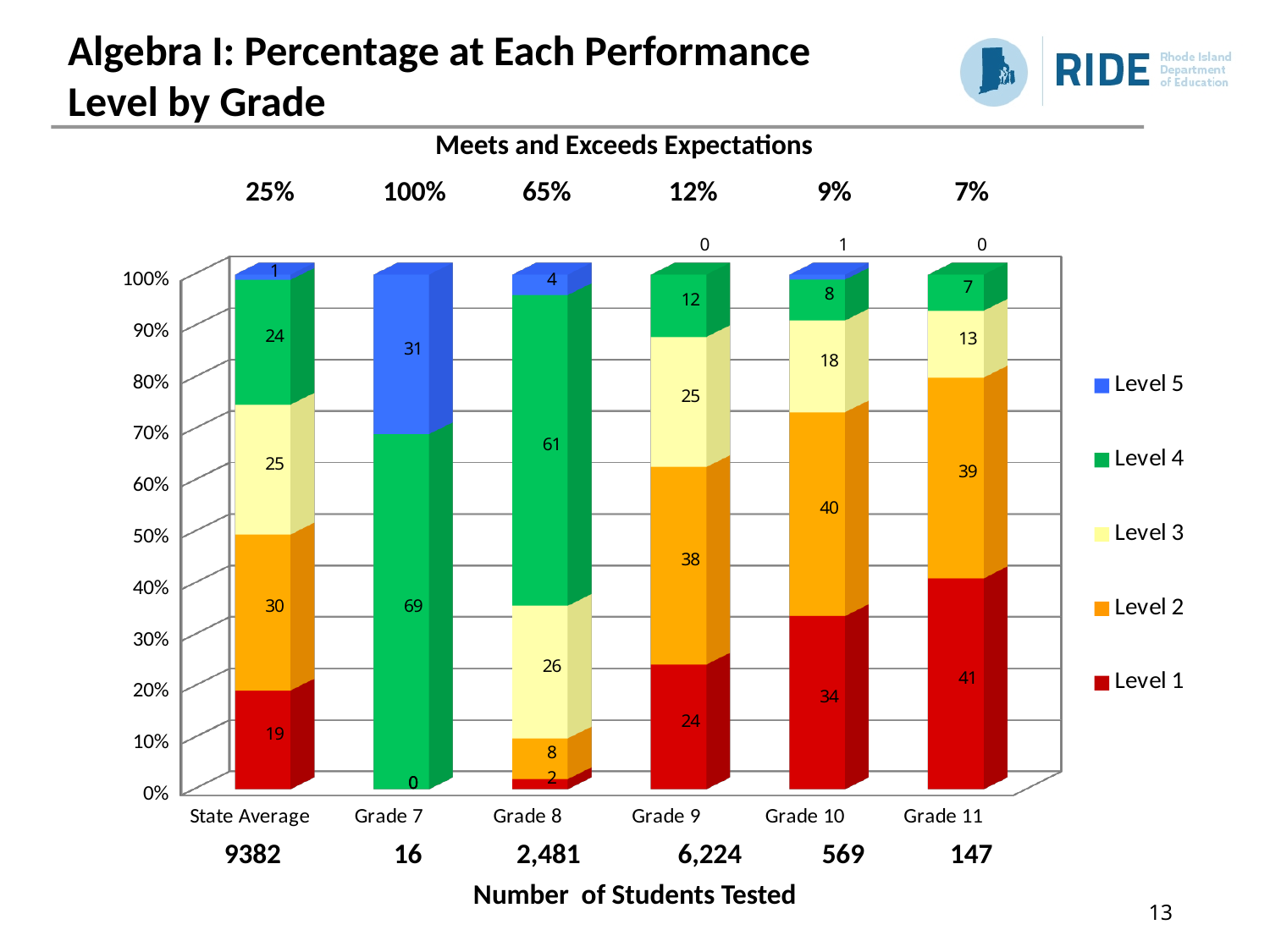
What kind of chart is shown on the slide? Stacked bar chart What is the Level 1 value for Grade 11? 41 What is the Level 2 value for the State Average? 30 What is the Meets and Exceeds Expectations percentage shown for Grade 9? 12% What is the difference between the Level 2 values for Grade 10 and Grade 9? 2 Which is larger, the Level 3 value for Grade 8 or the Level 3 value for Grade 10? Grade 8 Which grade has the highest Level 1 value? Grade 11 What is the Level 5 value for Grade 7? 31 How many series does the legend list? 5 What is the Level 4 value for Grade 8? 61 How many categories are shown on the x axis? 6 Which category has the lowest Level 4 value? Grade 11